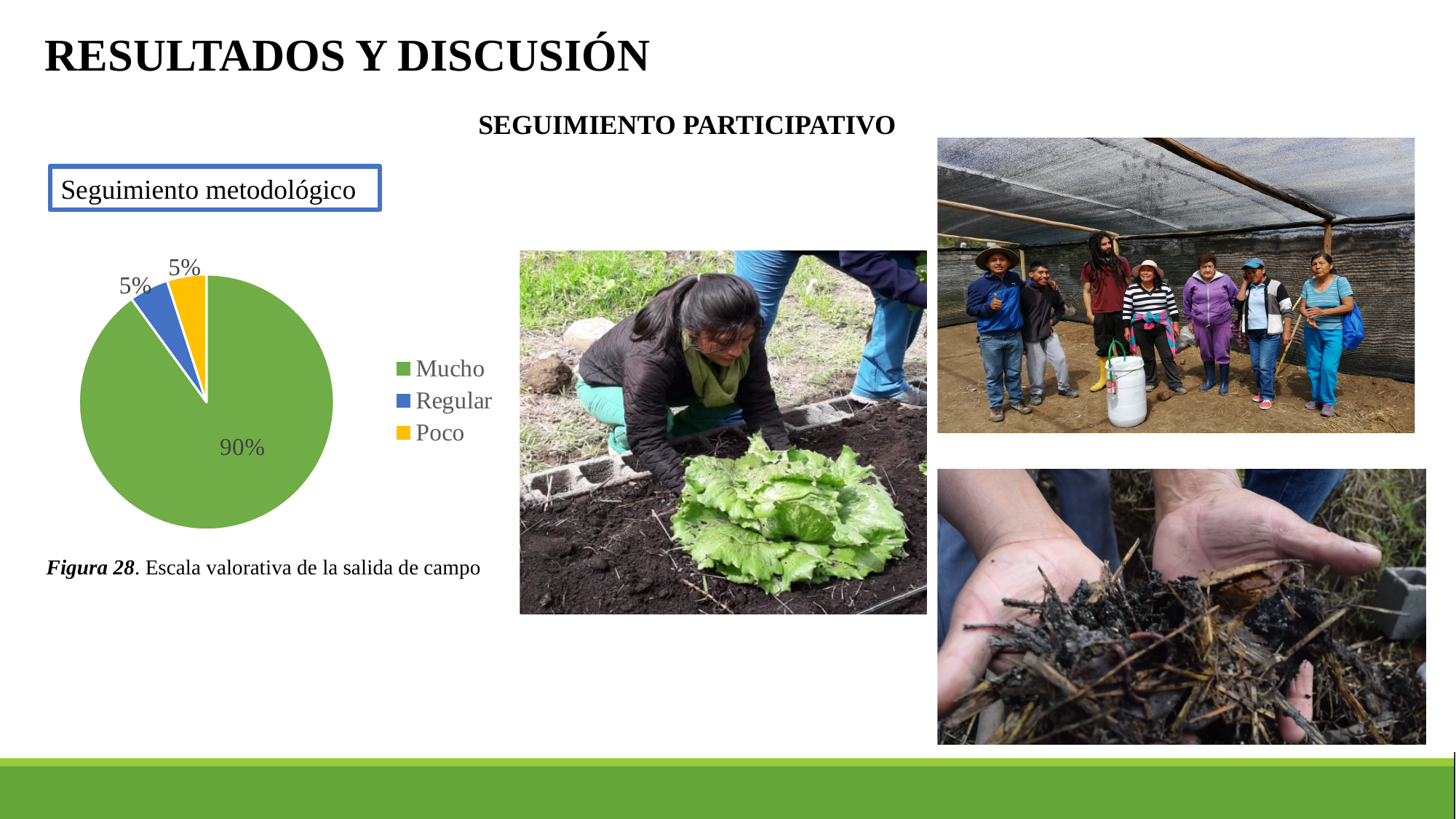
Which is larger in the pie chart, the Mucho slice or the Poco slice? Mucho What percentage of the pie chart is labelled Poco? 5% What is the difference in percentage points between the Mucho slice and the Regular slice? 85 What percentage of the pie chart is labelled Mucho? 90% What colour is the Mucho slice in the pie chart? green How many categories does the pie chart legend list? 3 What is the caption of the figure containing the pie chart? Figura 28. Escala valorativa de la salida de campo What is the combined share of the Regular and Poco slices? 10% Which category has the largest slice in the pie chart? Mucho What percentage of the pie chart is labelled Regular? 5% What kind of chart is shown on the slide? pie chart